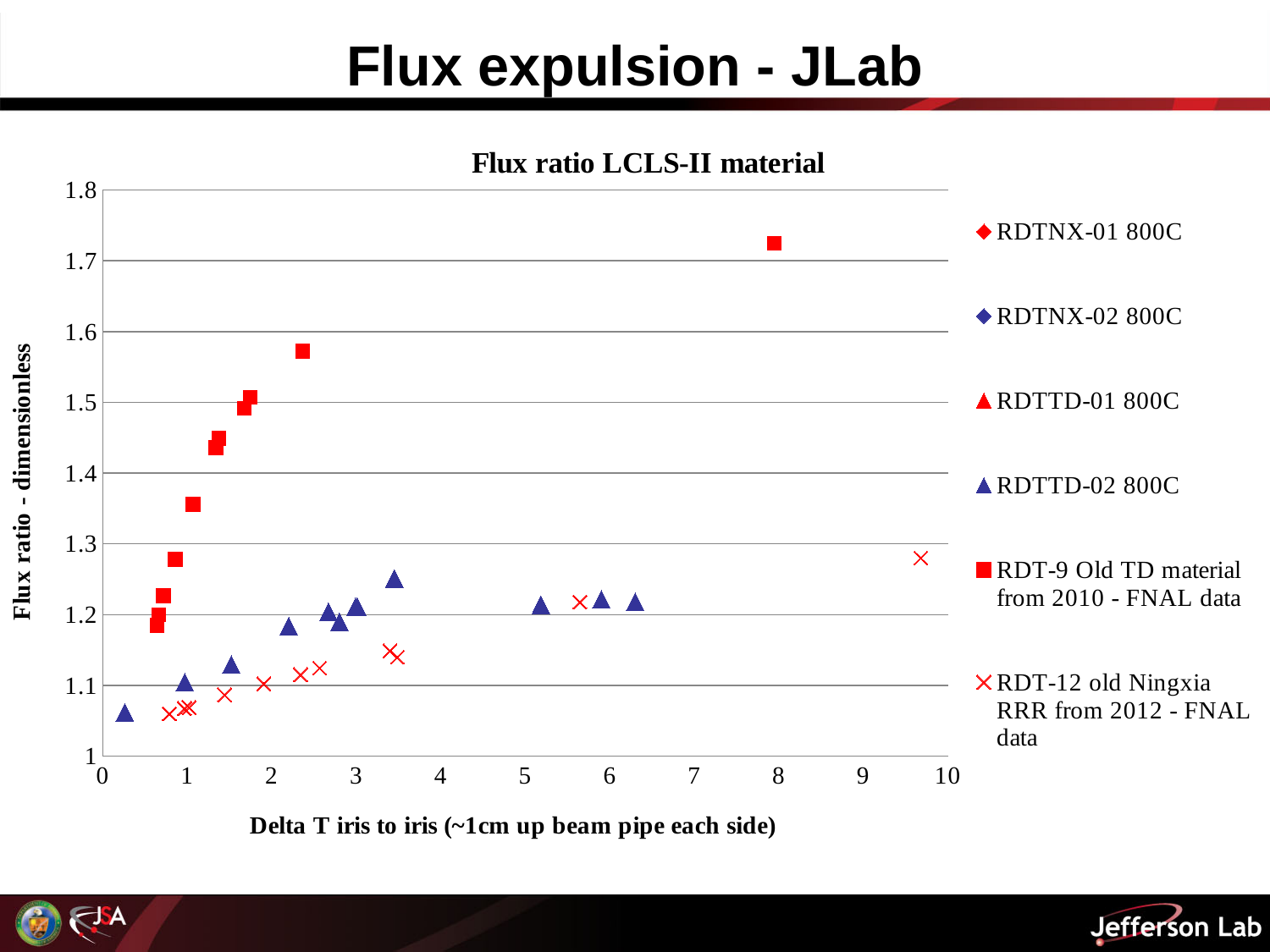
Which series reaches the highest flux ratio on the chart? RDT-9 Old TD material from 2010 - FNAL data Near Delta T of 1, which is larger: the RDT-9 Old TD material value or the RDTTD-02 800C value? RDT-9 Old TD material What kind of chart is shown on the slide? scatter chart How many series does the chart legend list? 6 Is the RDT-12 old Ningxia point near Delta T of 9.7 greater or less than 1.2? greater Are all the RDTTD-02 800C points greater or less than 1.3? less Is the highest RDT-9 Old TD material point greater or less than 1.7? greater What is the label of the x axis? Delta T iris to iris (~1cm up beam pipe each side) Do the RDT-9 Old TD material values rise or fall as Delta T increases? rise What is the highest value shown on the y axis? 1.8 What is the title of the chart? Flux ratio LCLS-II material